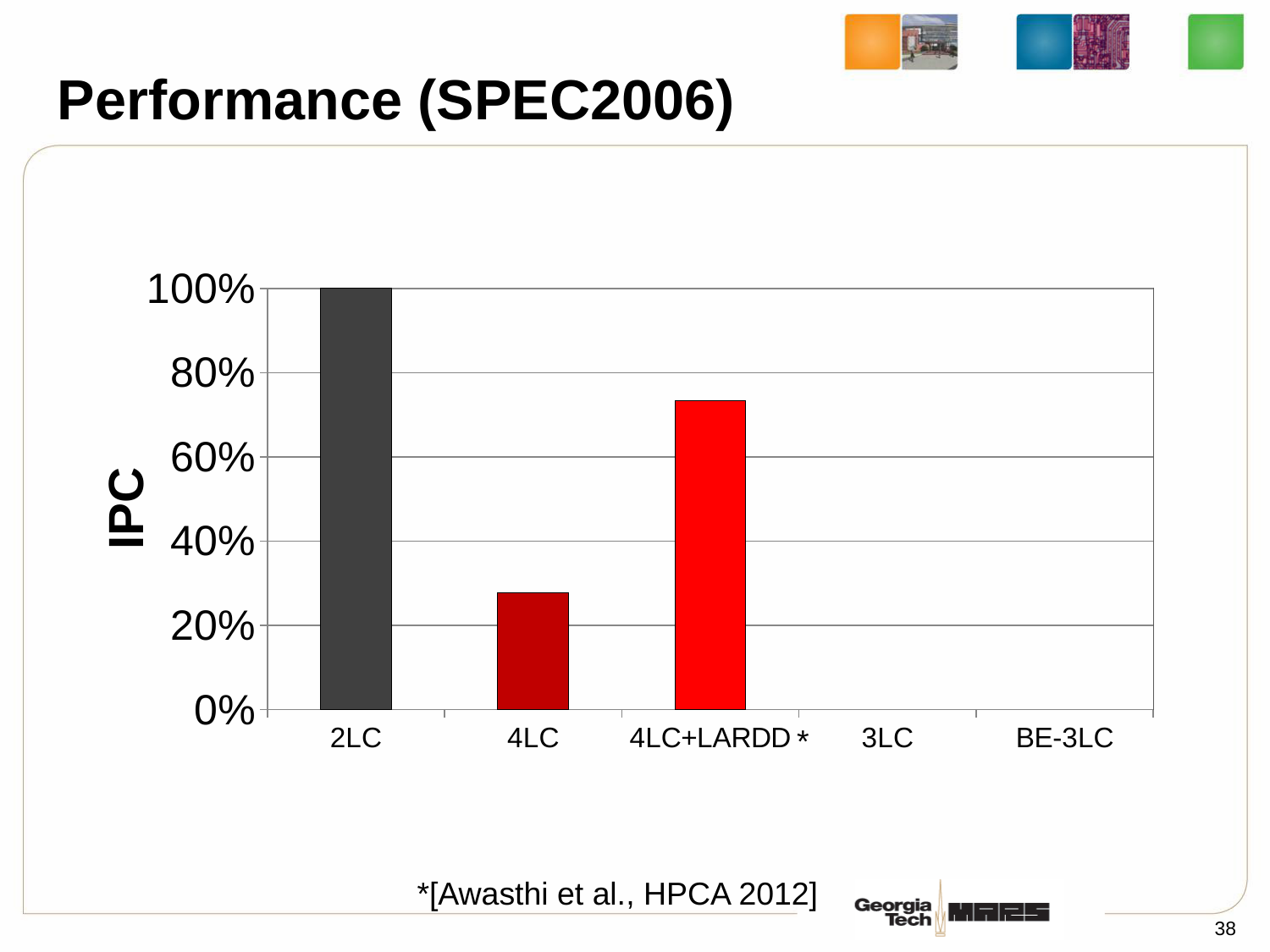
What is the IPC value for 2LC? 100% What is the label of the y axis? IPC Is the IPC value for 4LC greater or less than 40%? less Is the IPC value for 4LC+LARDD * greater or less than 80%? less Which has a higher IPC, 4LC or 4LC+LARDD *? 4LC+LARDD * Which category has the highest IPC? 2LC Is the IPC value for 4LC greater or less than 20%? greater Among the categories with a plotted bar, which has the lowest IPC? 4LC How many categories have a bar plotted in the chart? 3 How many categories are listed on the x axis? 5 What type of chart is shown on the slide? bar chart